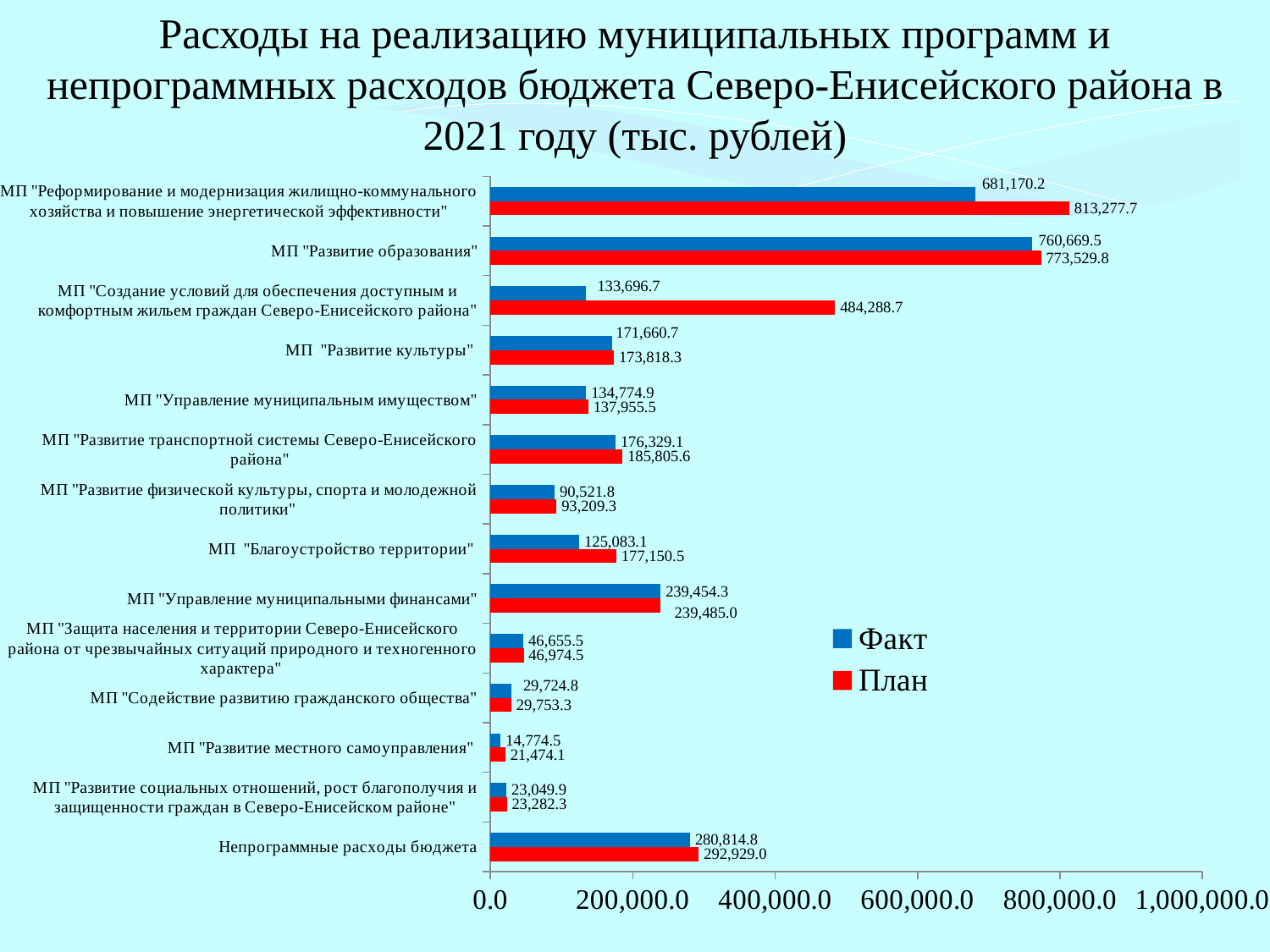
What is the План value for Непрограммные расходы бюджета? 292,929.0 Is the Факт value for МП "Управление муниципальными финансами" greater or less than 200,000.0? greater Which category has the lowest Факт value? МП "Развитие местного самоуправления" How many categories are shown on the chart? 14 What is the План value for МП "Создание условий для обеспечения доступным и комфортным жильем граждан Северо-Енисейского района"? 484,288.7 Which category has the highest План value? МП "Реформирование и модернизация жилищно-коммунального хозяйства и повышение энергетической эффективности" What is the difference between the План and Факт values for МП "Благоустройство территории"? 52,067.4 Which has the larger Факт value: МП "Развитие культуры" or МП "Развитие транспортной системы Северо-Енисейского района"? МП "Развитие транспортной системы Северо-Енисейского района" What is the Факт value for МП "Развитие образования"? 760,669.5 How many series does the legend list? 2 What kind of chart is shown on the slide? bar chart What is the difference between the План and Факт values for МП "Создание условий для обеспечения доступным и комфортным жильем граждан Северо-Енисейского района"? 350,592.0